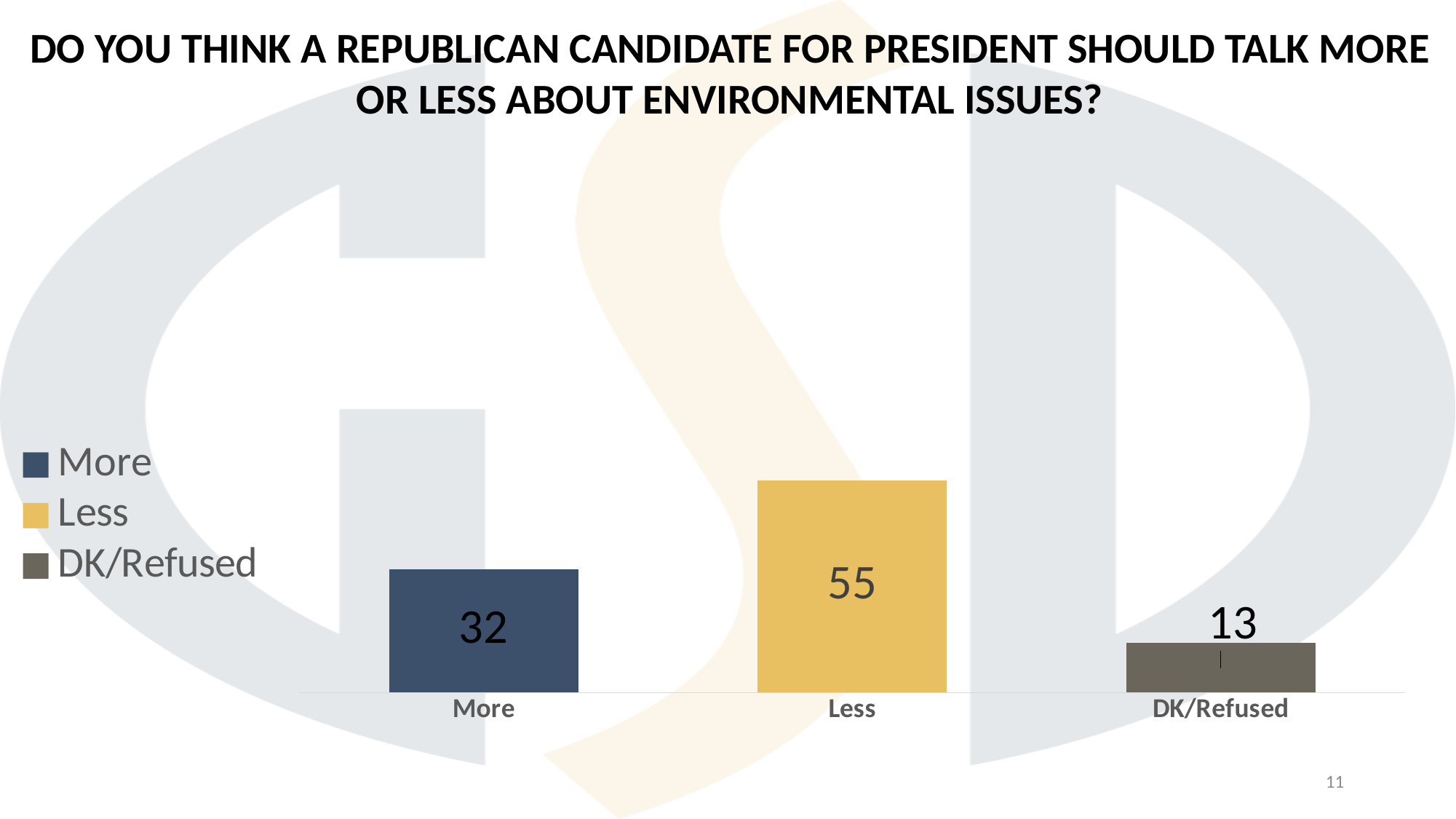
What is the difference between the values for "Less" and "More"? 23 What is the value for "Less"? 55 How many entries does the legend list? 3 How many categories are shown in the chart? 3 What kind of chart is shown on the slide? Bar chart What is the difference between the values for "More" and "DK/Refused"? 19 What is the value for "DK/Refused"? 13 Which category has the highest value? Less What colour is the bar for "Less"? Yellow What is the value for "More"? 32 Which category has the lowest value? DK/Refused Which is larger, the value for "More" or the value for "Less"? Less